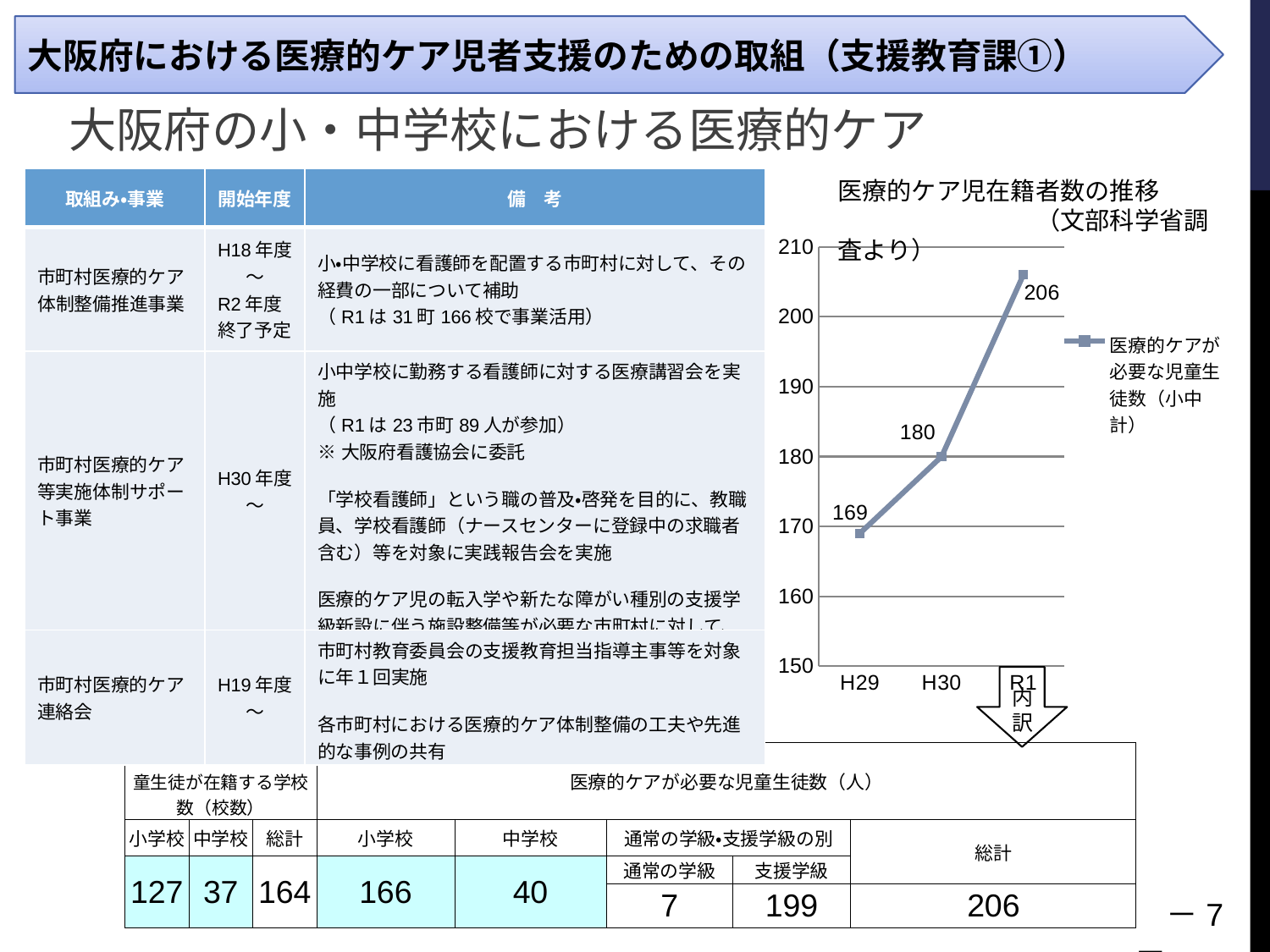
Is the value for R1 in the line chart greater or less than 200? greater What is the difference between the H30 value and the H29 value in the line chart? 11 What is the difference between the R1 value and the H29 value in the line chart? 37 Which year has the lowest value in the line chart? H29 How many data points are plotted in the line chart? 3 What is the value for H29 in the line chart? 169 Which year has the highest value in the line chart? R1 What kind of chart is shown on the slide? line chart What is the value for R1 in the line chart? 206 What is the value for H30 in the line chart? 180 Which is larger in the line chart, the value for H30 or the value for R1? R1 Do the values in the line chart rise or fall from H29 to R1? rise